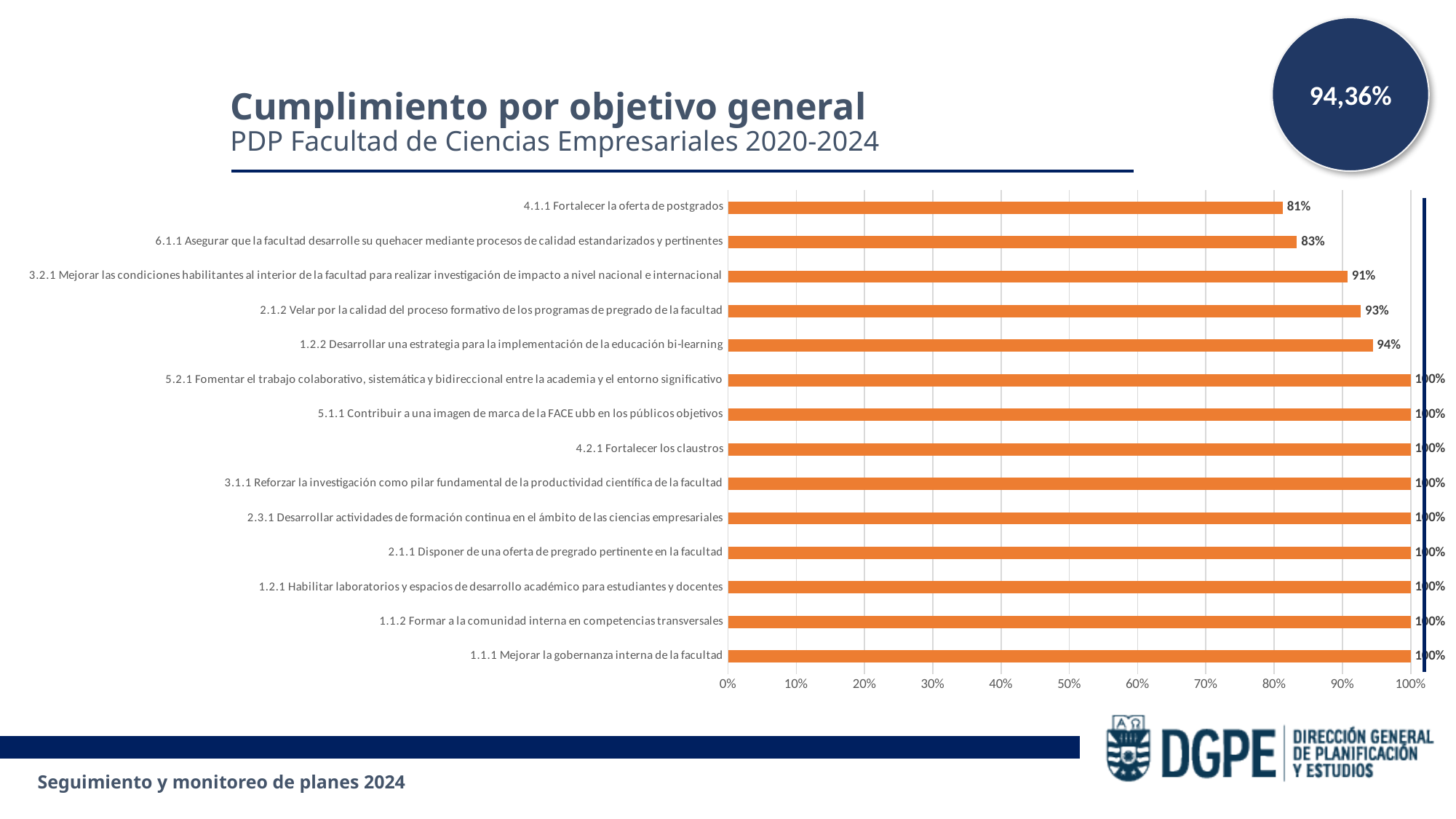
Which is larger: the value for 3.2.1 Mejorar las condiciones habilitantes al interior de la facultad para realizar investigación de impacto a nivel nacional e internacional or the value for 2.1.2 Velar por la calidad del proceso formativo de los programas de pregrado de la facultad? 2.1.2 Velar por la calidad del proceso formativo de los programas de pregrado de la facultad What is the value for 1.2.2 Desarrollar una estrategia para la implementación de la educación bi-learning? 94% What is the value for 4.1.1 Fortalecer la oferta de postgrados? 81% How many objectives have a value of 100%? 9 What kind of chart is shown on the slide? Bar chart What is the value for 2.1.2 Velar por la calidad del proceso formativo de los programas de pregrado de la facultad? 93% What is the title of the chart? Cumplimiento por objetivo general Is the value for 4.1.1 Fortalecer la oferta de postgrados greater or less than 90%? less What is the value for 4.2.1 Fortalecer los claustros? 100% How many objectives are shown in the chart? 14 What is the difference between the values for 6.1.1 Asegurar que la facultad desarrolle su quehacer mediante procesos de calidad estandarizados y pertinentes and 4.1.1 Fortalecer la oferta de postgrados? 2 percentage points Which objective has the lowest value? 4.1.1 Fortalecer la oferta de postgrados